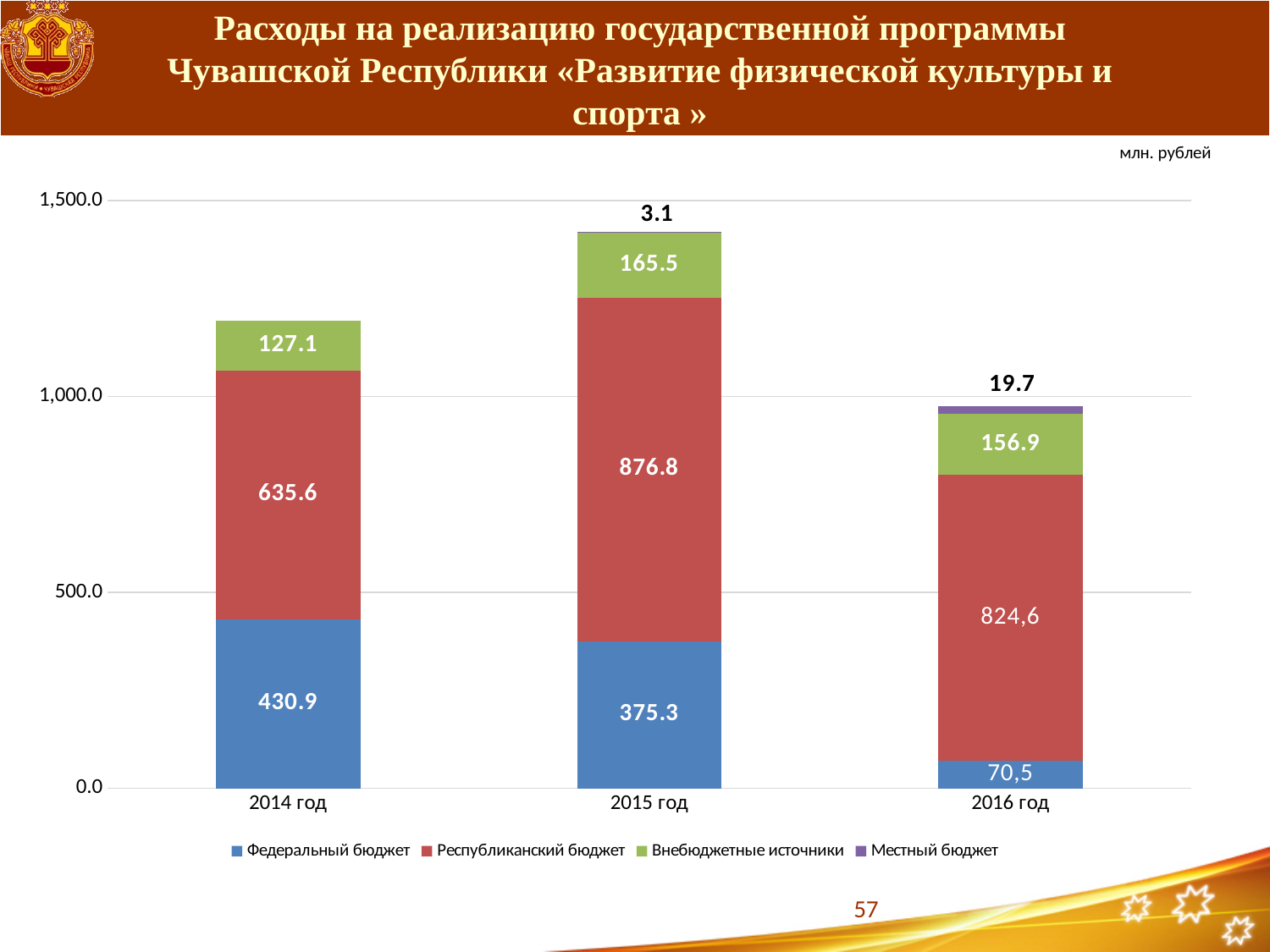
What is the difference between Внебюджетные источники in 2015 год and 2014 год? 38.4 What is the value of Федеральный бюджет for 2016 год? 70,5 In which year is Федеральный бюджет the lowest? 2016 год What is the value of Местный бюджет for 2016 год? 19.7 What is the total of the stacked bar for 2015 год? 1420.7 How many series does the legend list? 4 How many years are shown on the x axis? 3 In which year is Республиканский бюджет the highest? 2015 год What is the value of Федеральный бюджет for 2014 год? 430.9 What kind of chart is shown on the slide? Stacked bar chart What is the value of Республиканский бюджет for 2015 год? 876.8 Does Федеральный бюджет rise or fall from 2014 год to 2016 год? Fall